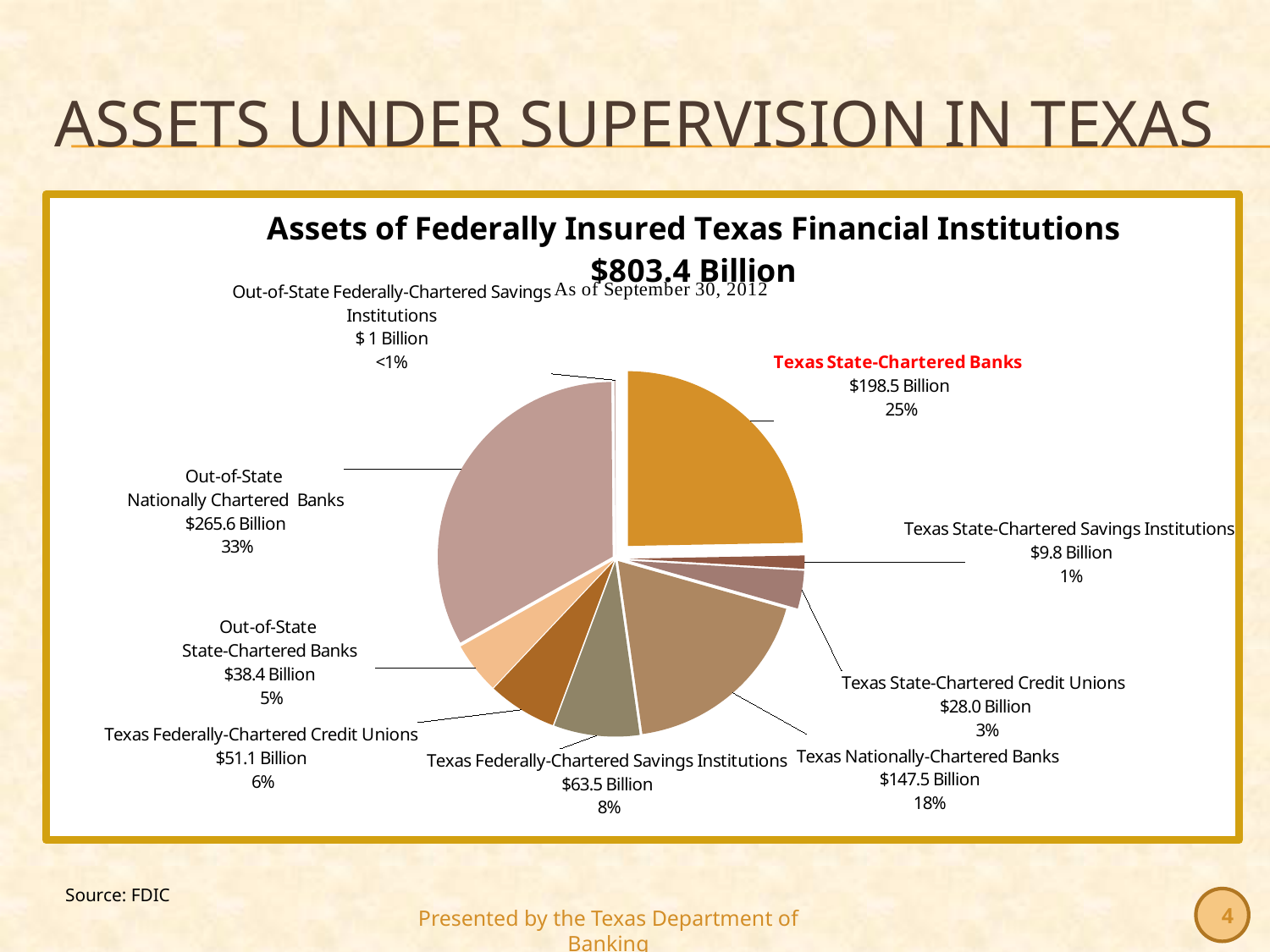
How many categories are shown in the pie chart? 9 What is the value for Texas State-Chartered Banks? $198.5 Billion What is the value for Texas Nationally-Chartered Banks? $147.5 Billion What type of chart is shown on the slide? Pie chart What share of the pie do Texas Federally-Chartered Savings Institutions represent? 8% What is the difference in value between Texas State-Chartered Banks and Texas Nationally-Chartered Banks? $51.0 Billion What share of the pie do Out-of-State State-Chartered Banks represent? 5% Which category has the smallest share of the pie? Out-of-State Federally-Chartered Savings Institutions What is the value for Texas State-Chartered Credit Unions? $28.0 Billion Which category has the largest share of the pie? Out-of-State Nationally Chartered Banks Which is larger, Texas Federally-Chartered Credit Unions or Out-of-State State-Chartered Banks? Texas Federally-Chartered Credit Unions What total value is stated in the chart title? $803.4 Billion